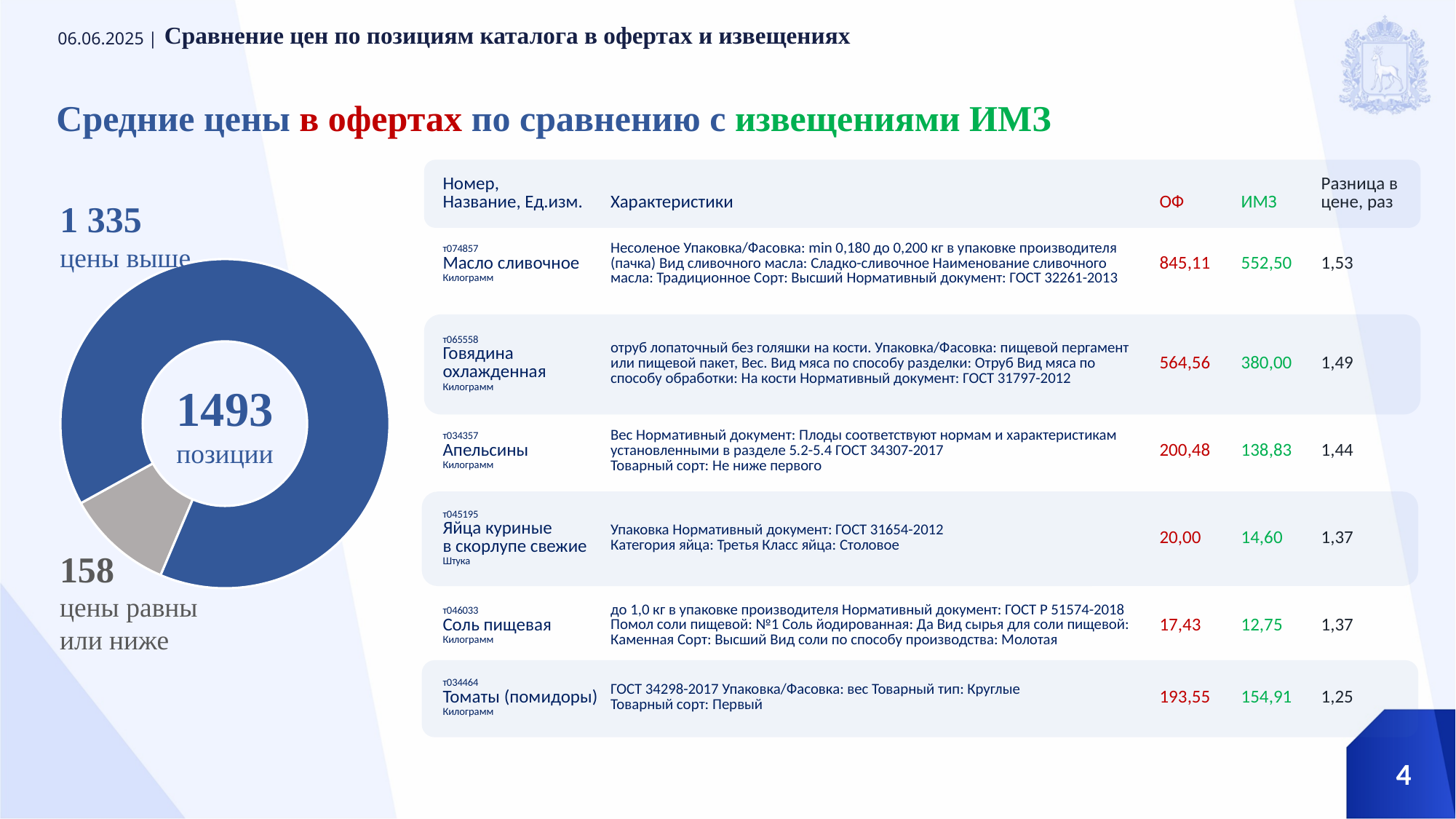
How many positions are in the segment labelled "цены выше"? 1 335 Which segment of the donut chart is the largest? цены выше Which is larger: the number of positions with "цены выше" or with "цены равны или ниже"? цены выше How many segments does the donut chart have? 2 What kind of chart is shown on the left of the slide? pie chart (donut) What total number of positions is shown in the centre of the donut chart? 1493 What colour is the "цены выше" segment of the donut chart? blue What is the difference between the number of positions with "цены выше" and "цены равны или ниже"? 1 177 What word is written under the number 1493 in the centre of the donut chart? позиции Which segment of the donut chart is the smallest? цены равны или ниже How many positions are in the segment labelled "цены равны или ниже"? 158